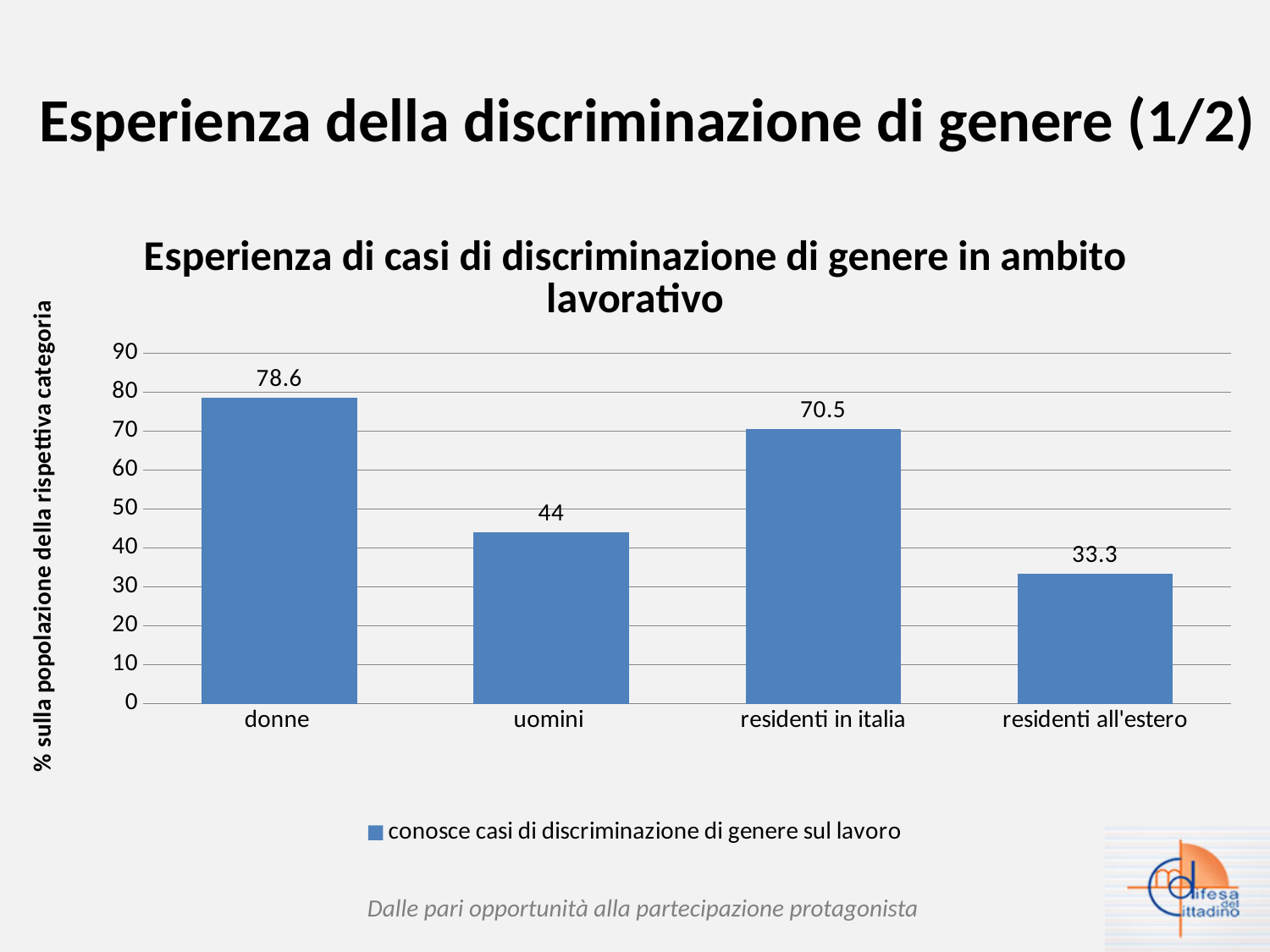
What is the value for residenti in italia? 70.5 What is the legend entry for the series shown? conosce casi di discriminazione di genere sul lavoro How many categories are shown on the x axis? 4 What is the value for uomini? 44 What is the value for residenti all'estero? 33.3 Which category has the highest value? donne What kind of chart is shown on the slide? bar chart Is the value for uomini greater or less than 50? less What is the difference between the values for donne and uomini? 34.6 What is the value for donne? 78.6 Which category has the lowest value? residenti all'estero Which is larger, the value for residenti in italia or the value for residenti all'estero? residenti in italia